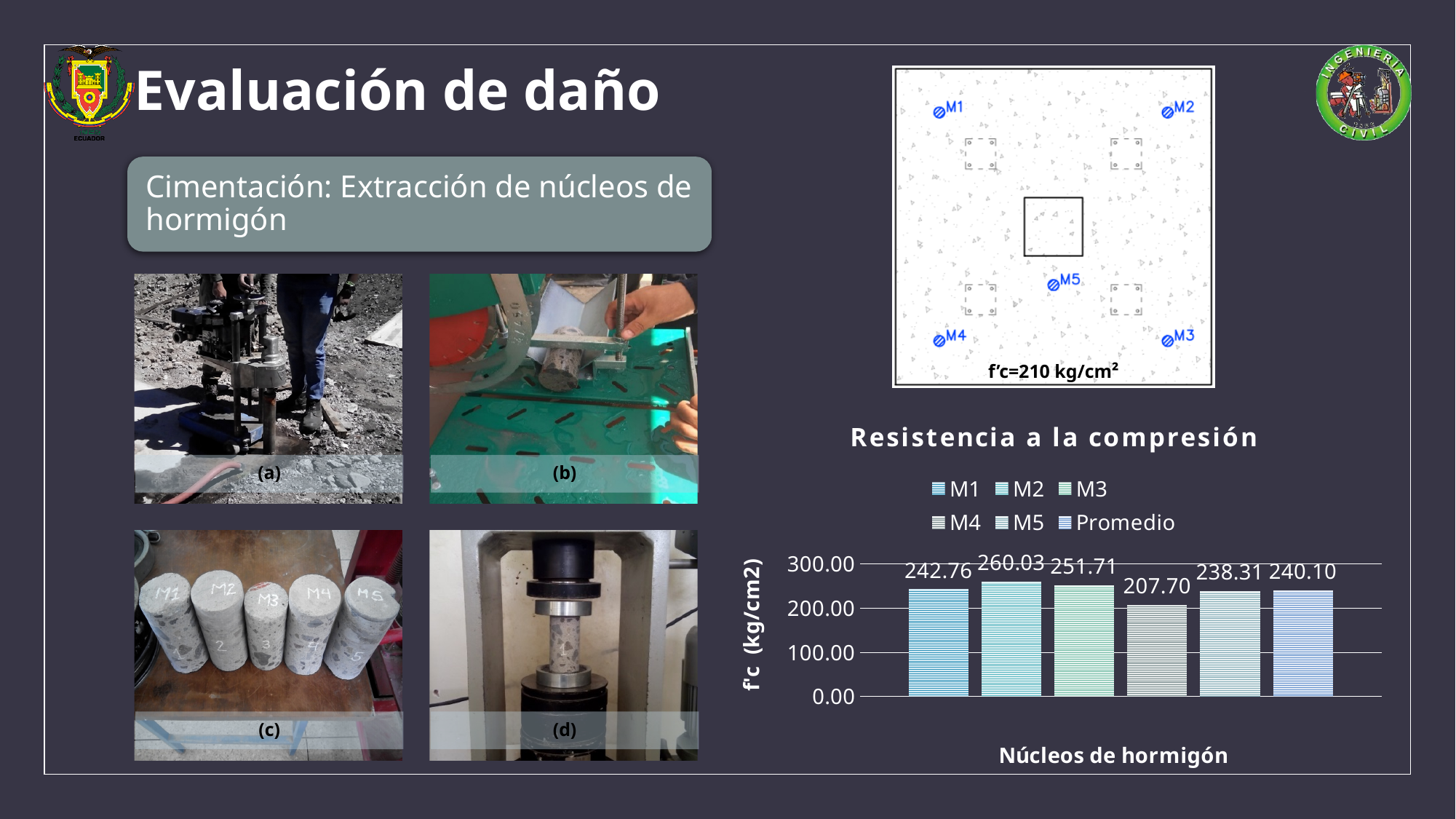
Which core has the lowest compressive strength in the chart? M4 Which core has the highest compressive strength in the chart? M2 Is the value for M4 greater or less than 200.00? greater What is the label of the horizontal axis in the 'Resistencia a la compresión' chart? Núcleos de hormigón What is the difference between the values for M2 and M4? 52.33 What is the label of the vertical axis in the 'Resistencia a la compresión' chart? f'c (kg/cm2) What is the value shown for Promedio in the chart? 240.10 What is the compressive strength value shown for M1? 242.76 How many entries does the legend of the 'Resistencia a la compresión' chart list? 6 What is the value shown for M4 in the 'Resistencia a la compresión' chart? 207.70 What type of chart is shown under the title 'Resistencia a la compresión'? bar chart Which is larger, the value for M3 or the value for M5? M3